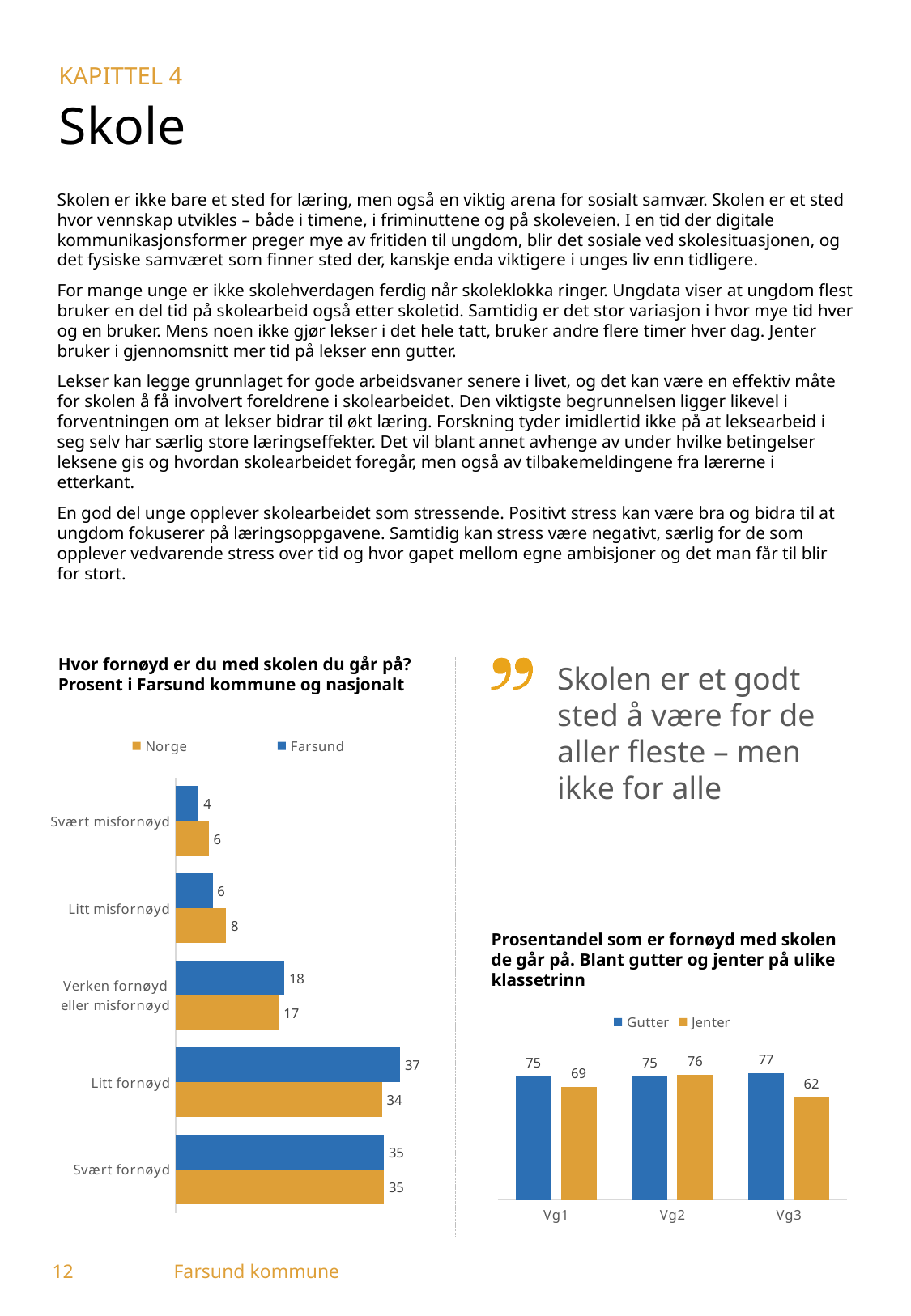
In the chart 'Hvor fornøyd er du med skolen du går på?', what is the Norge value for 'Svært misfornøyd'? 6 What kind of chart is 'Hvor fornøyd er du med skolen du går på?'? Bar chart In the chart 'Hvor fornøyd er du med skolen du går på?', what is the difference between the Farsund and Norge values for 'Litt fornøyd'? 3 In the chart 'Prosentandel som er fornøyd med skolen de går på', which class level has the highest Gutter value? Vg3 In the chart 'Hvor fornøyd er du med skolen du går på?', what is the Farsund value for 'Litt fornøyd'? 37 In the chart 'Hvor fornøyd er du med skolen du går på?', which category has the highest Farsund value? Litt fornøyd In the chart 'Prosentandel som er fornøyd med skolen de går på', is the Gutter or Jenter value larger for Vg2? Jenter In the chart 'Prosentandel som er fornøyd med skolen de går på', what is the difference between the Gutter and Jenter values for Vg3? 15 In the chart 'Hvor fornøyd er du med skolen du går på?', how many categories are shown? 5 In the chart 'Hvor fornøyd er du med skolen du går på?', how many series does the legend list? 2 In the chart 'Prosentandel som er fornøyd med skolen de går på', what is the Jenter value for Vg3? 62 In the chart 'Hvor fornøyd er du med skolen du går på?', which category has the lowest Norge value? Svært misfornøyd